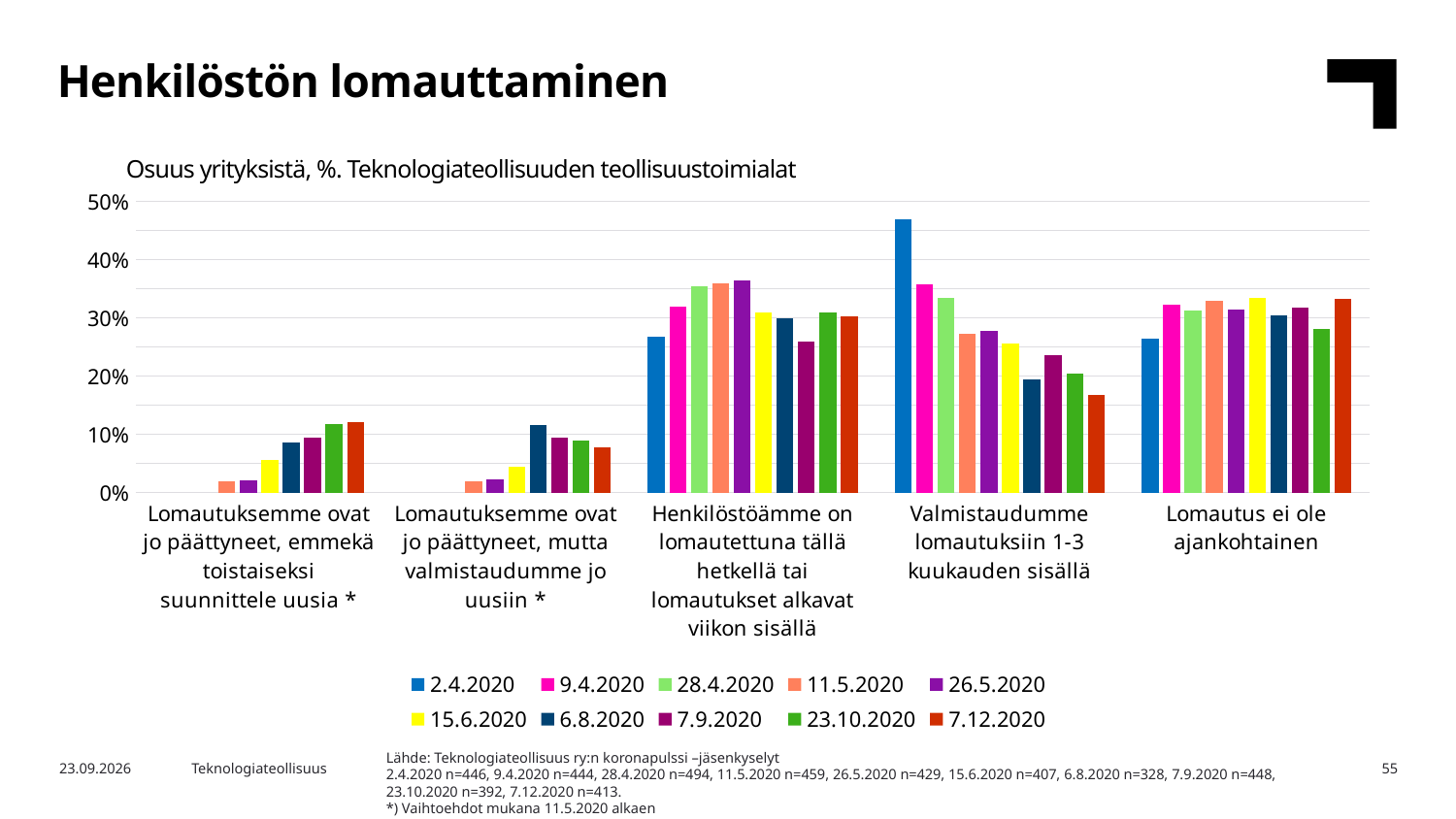
In the category 'Lomautus ei ole ajankohtainen', which is larger: the value for 23.10.2020 or for 7.12.2020? 7.12.2020 How many categories are shown on the x axis? 5 Is the value for 7.9.2020 in the category 'Valmistaudumme lomautuksiin 1-3 kuukauden sisällä' greater or less than 20%? greater In the category 'Lomautuksemme ovat jo päättyneet, emmekä toistaiseksi suunnittele uusia *', do the values generally rise or fall from the 11.5.2020 survey to the 7.12.2020 survey? rise What is the title of the slide? Henkilöstön lomauttaminen What kind of chart is shown on the slide? bar chart Is the value for 7.12.2020 in the category 'Valmistaudumme lomautuksiin 1-3 kuukauden sisällä' greater or less than 20%? less Is the value for 2.4.2020 in the category 'Valmistaudumme lomautuksiin 1-3 kuukauden sisällä' greater or less than 40%? greater In the category 'Henkilöstöämme on lomautettuna tällä hetkellä tai lomautukset alkavat viikon sisällä', which is larger: the value for 2.4.2020 or for 26.5.2020? 26.5.2020 In the category 'Valmistaudumme lomautuksiin 1-3 kuukauden sisällä', do the values generally rise or fall from the 2.4.2020 survey to the 7.12.2020 survey? fall How many series does the legend list? 10 For the 2.4.2020 series, which category has the highest value? Valmistaudumme lomautuksiin 1-3 kuukauden sisällä